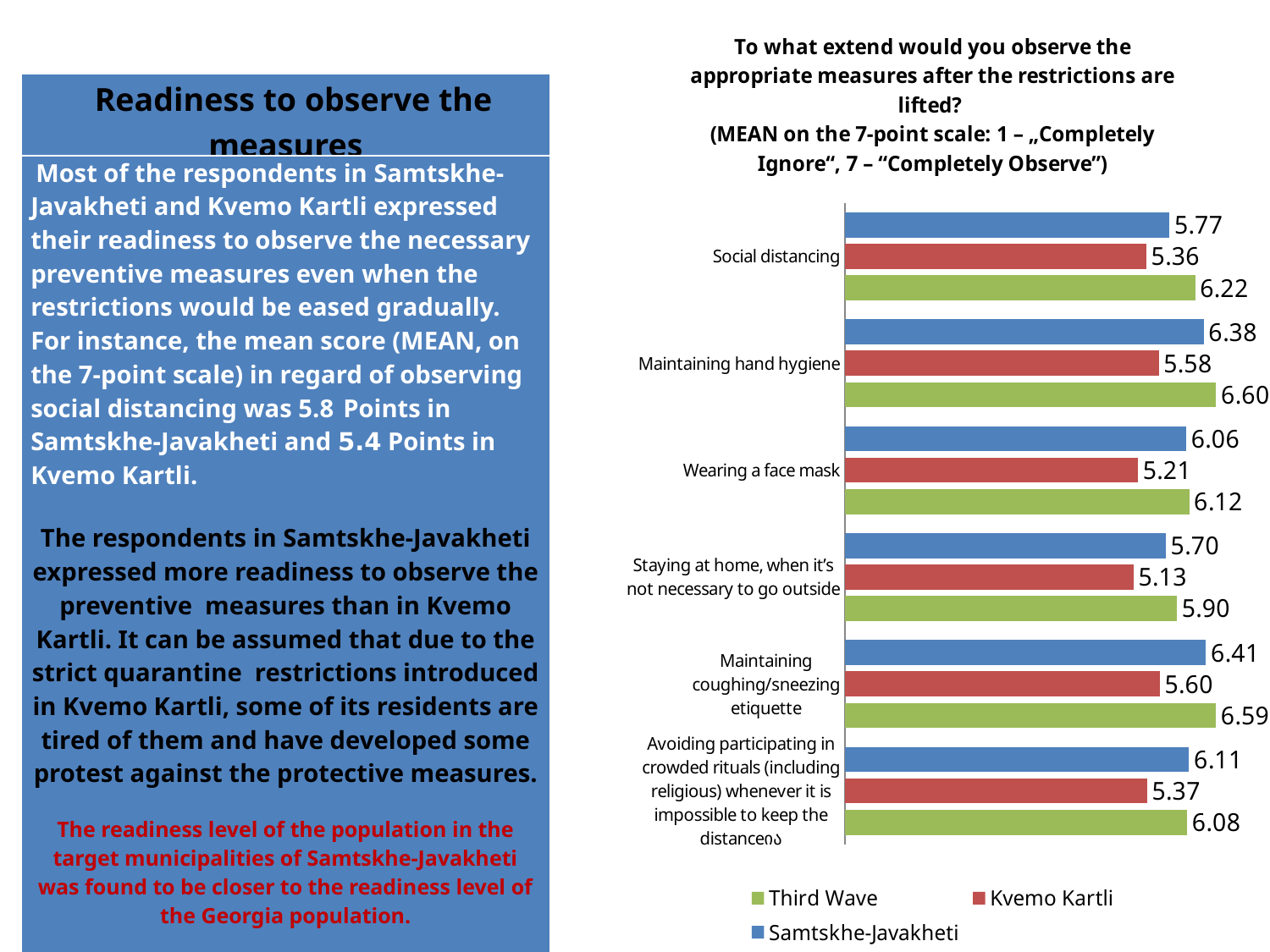
What is the value for Samtskhe-Javakheti for Maintaining hand hygiene? 6.38 How many series does the legend list? 3 What is the difference between the Third Wave and Kvemo Kartli values for Maintaining hand hygiene? 1.02 What is the value for Kvemo Kartli for Social distancing? 5.36 For Staying at home, when it's not necessary to go outside, which is larger: the Kvemo Kartli value or the Samtskhe-Javakheti value? Samtskhe-Javakheti Which category has the highest value for Samtskhe-Javakheti? Maintaining coughing/sneezing etiquette What kind of chart is shown on the slide? Bar chart What is the Third Wave value for Wearing a face mask? 6.12 What is the difference between the Samtskhe-Javakheti and Kvemo Kartli values for Social distancing? 0.41 For Avoiding participating in crowded rituals, which is larger: the Samtskhe-Javakheti value or the Third Wave value? Samtskhe-Javakheti How many categories are shown on the chart? 6 Which category has the lowest value for Kvemo Kartli? Staying at home, when it's not necessary to go outside